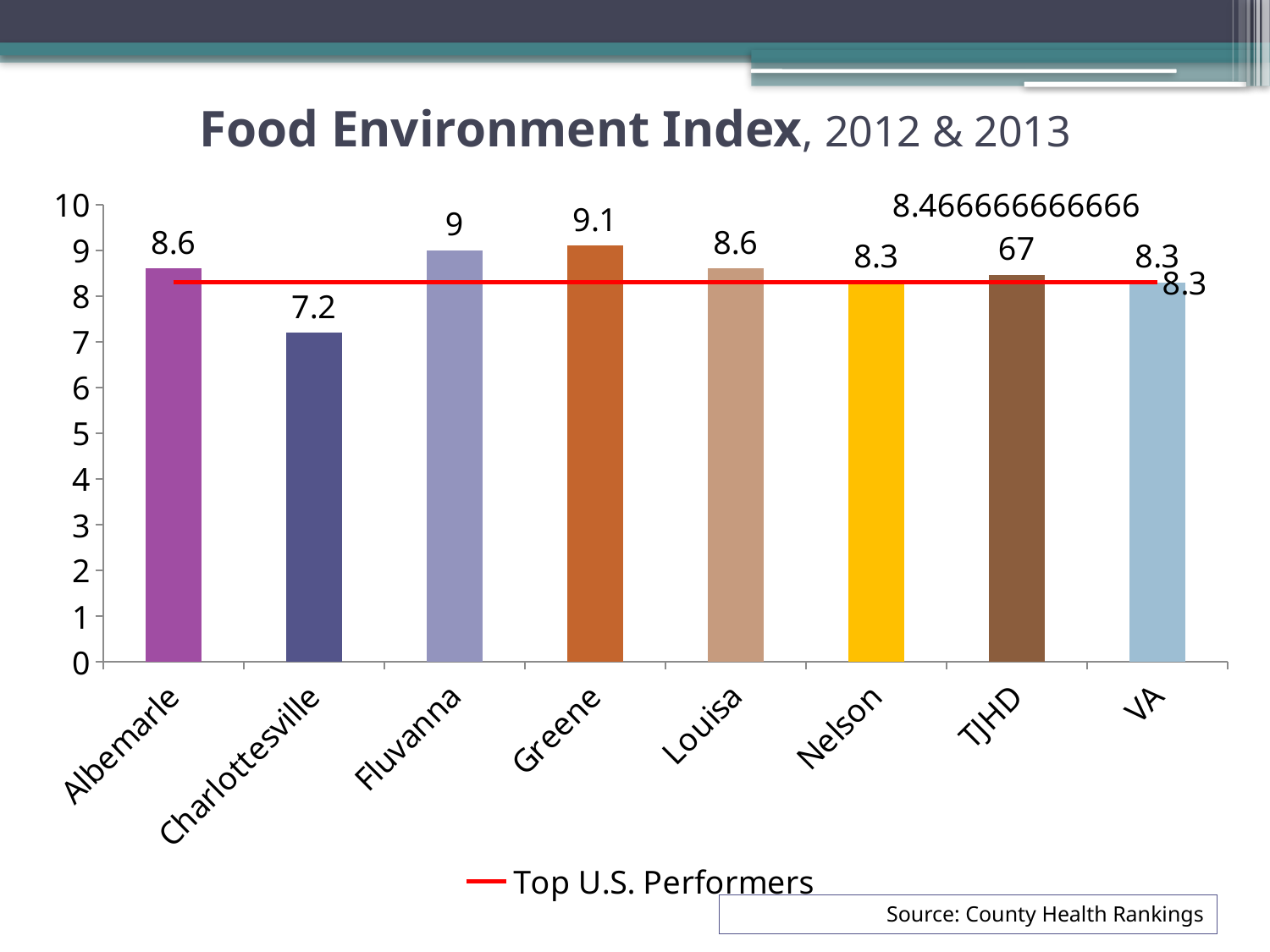
What is the difference between the Food Environment Index values for Greene and Charlottesville? 1.9 Which has a higher Food Environment Index, Albemarle or Nelson? Albemarle Which locality has the lowest Food Environment Index? Charlottesville Which locality has the highest Food Environment Index? Greene What is the Food Environment Index value for Fluvanna? 9 How many localities are shown on the x axis of the chart? 8 Is the value for Charlottesville greater or less than 8? less What is the Food Environment Index value for Charlottesville? 7.2 What is the Food Environment Index value for VA? 8.3 What is the Food Environment Index value for Greene? 9.1 What kind of chart is shown on the slide? bar chart What does the red horizontal line on the chart represent, according to the legend? Top U.S. Performers